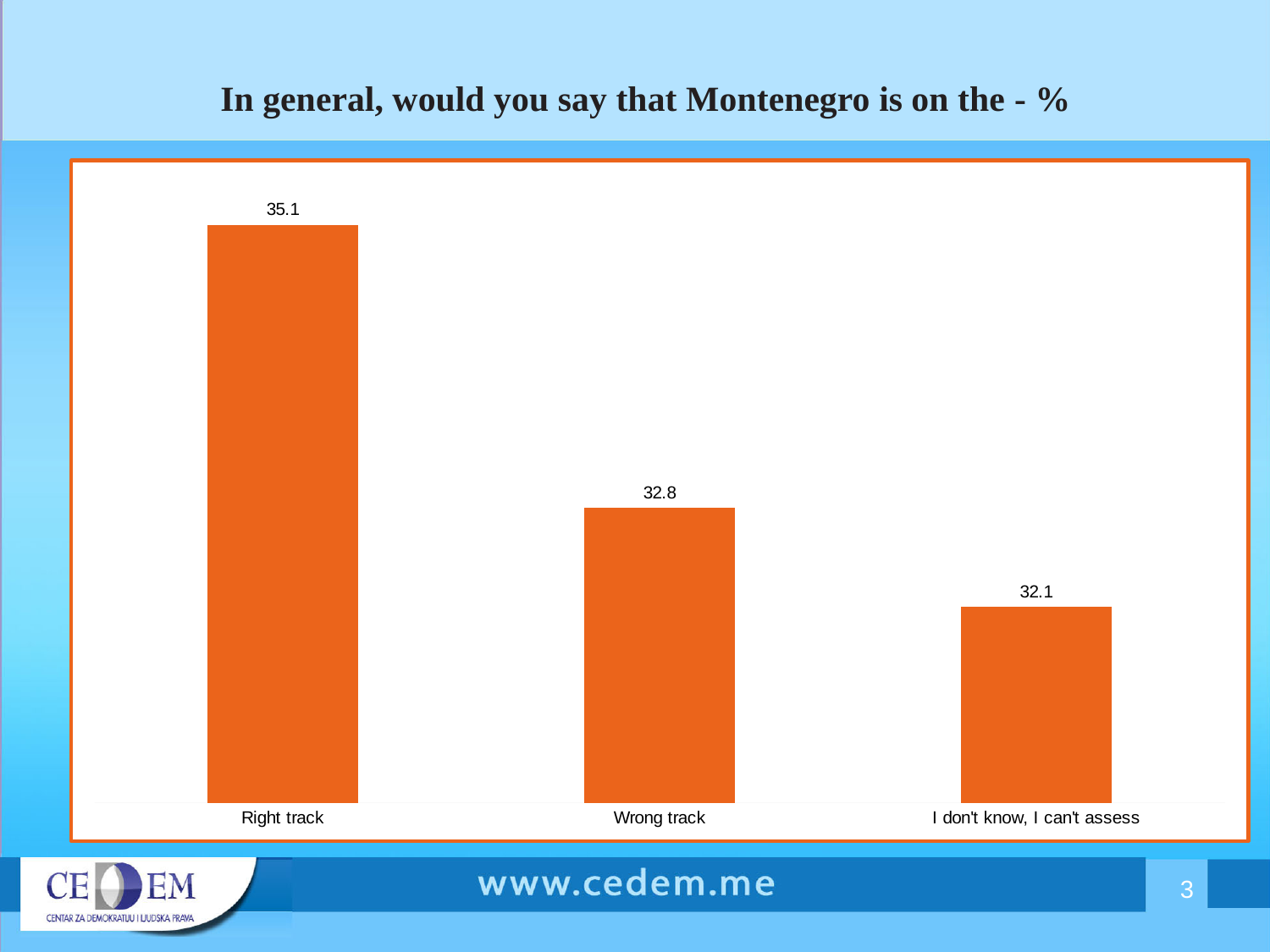
Which category has the highest value? Right track What is the title of the chart? In general, would you say that Montenegro is on the - % How many categories are shown in the chart? 3 Do the values rise or fall from left to right across the categories? Fall What kind of chart is shown on the slide? Bar chart What is the value for Right track? 35.1 Which is larger, the value for Right track or the value for I don't know, I can't assess? Right track What is the value for Wrong track? 32.8 What is the value for I don't know, I can't assess? 32.1 Which category has the lowest value? I don't know, I can't assess What is the difference between the values for Wrong track and I don't know, I can't assess? 0.7 What is the difference between the values for Right track and Wrong track? 2.3